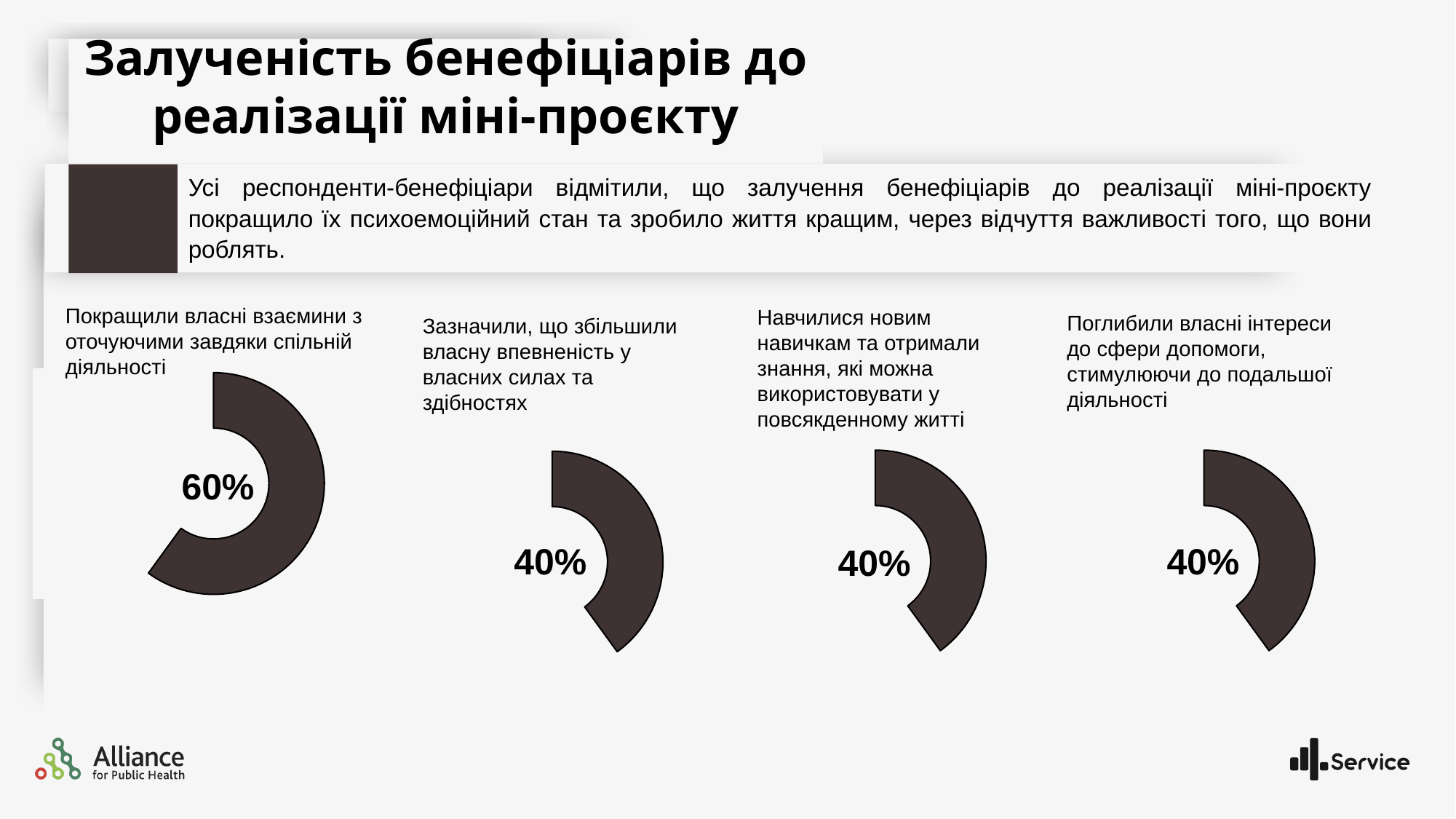
What value is shown on the leftmost chart, labelled "Покращили власні взаємини з оточуючими завдяки спільній діяльності"? 60% Which is larger: the value on the leftmost chart or the value on the second chart from the left? The leftmost chart (60%) What value is shown on the chart labelled "Навчилися новим навичкам та отримали знання, які можна використовувати у повсякденному житті"? 40% What value is shown on the rightmost chart, labelled "Поглибили власні інтереси до сфери допомоги, стимулюючи до подальшої діяльності"? 40% Which of the four charts on the slide shows the highest value? Покращили власні взаємини з оточуючими завдяки спільній діяльності (60%) Is the value on the leftmost chart greater or less than 50%? greater How many charts are shown on the slide? 4 What is the title of the slide containing the charts? Залученість бенефіціарів до реалізації міні-проєкту What kind of chart is used to display each percentage on the slide? Donut (ring) chart What is the difference between the value on the leftmost chart (60%) and the value on the rightmost chart (40%)? 20 percentage points How many of the four charts show a value of 40%? 3 What value is shown on the chart labelled "Зазначили, що збільшили власну впевненість у власних силах та здібностях"? 40%